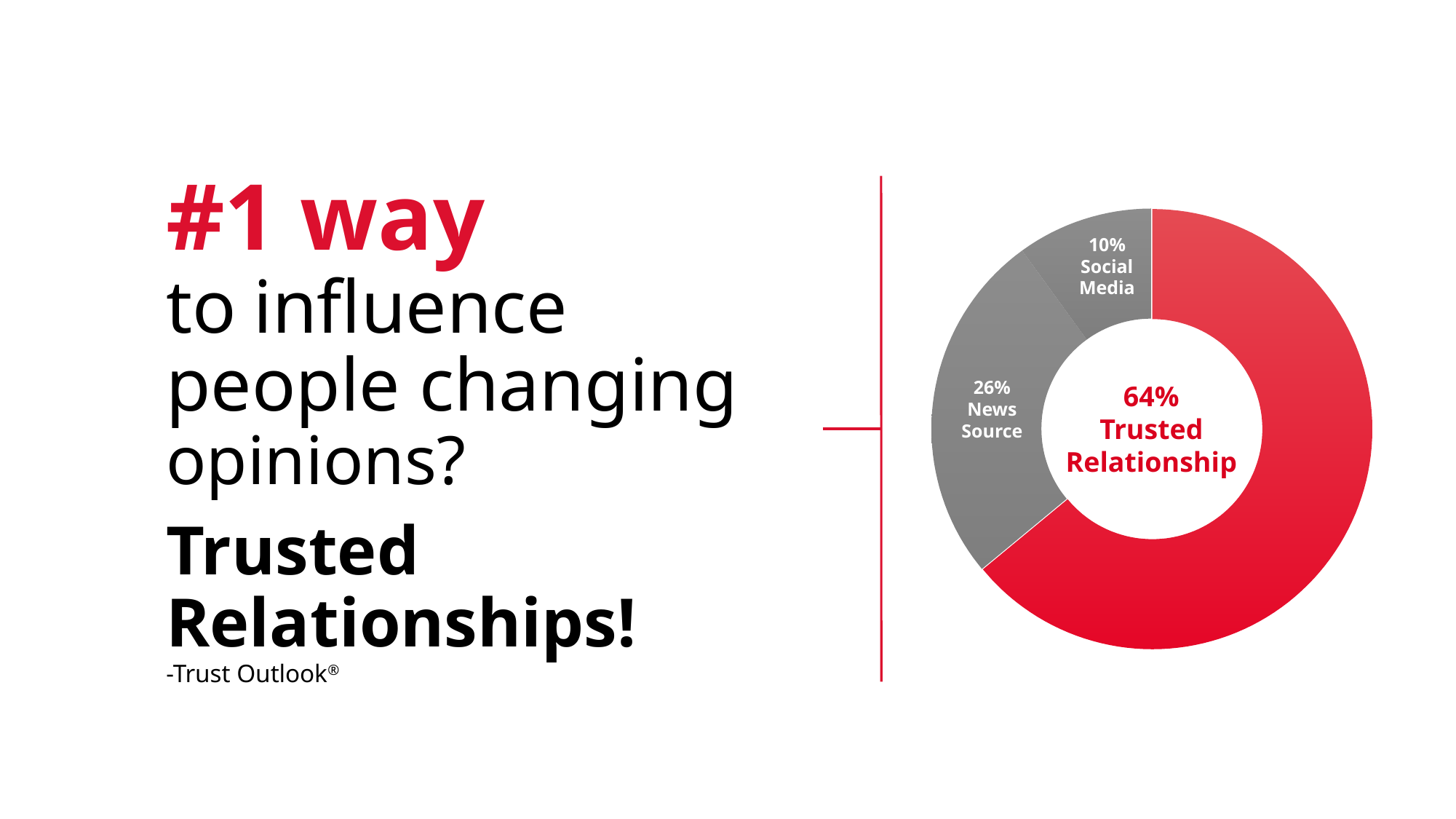
What is the difference in percentage points between Trusted Relationship and News Source? 38 Which category has the largest share in the chart? Trusted Relationship What percentage does the chart show for News Source? 26% Which is larger, the share for News Source or the share for Social Media? News Source What kind of chart is shown on the slide? Doughnut (pie) chart What is the combined share of News Source and Social Media? 36% What colour is the Trusted Relationship segment of the chart? Red What is the difference in percentage points between News Source and Social Media? 16 Which category has the smallest share in the chart? Social Media How many categories are shown in the chart? 3 What percentage does the chart show for Trusted Relationship? 64% What percentage does the chart show for Social Media? 10%